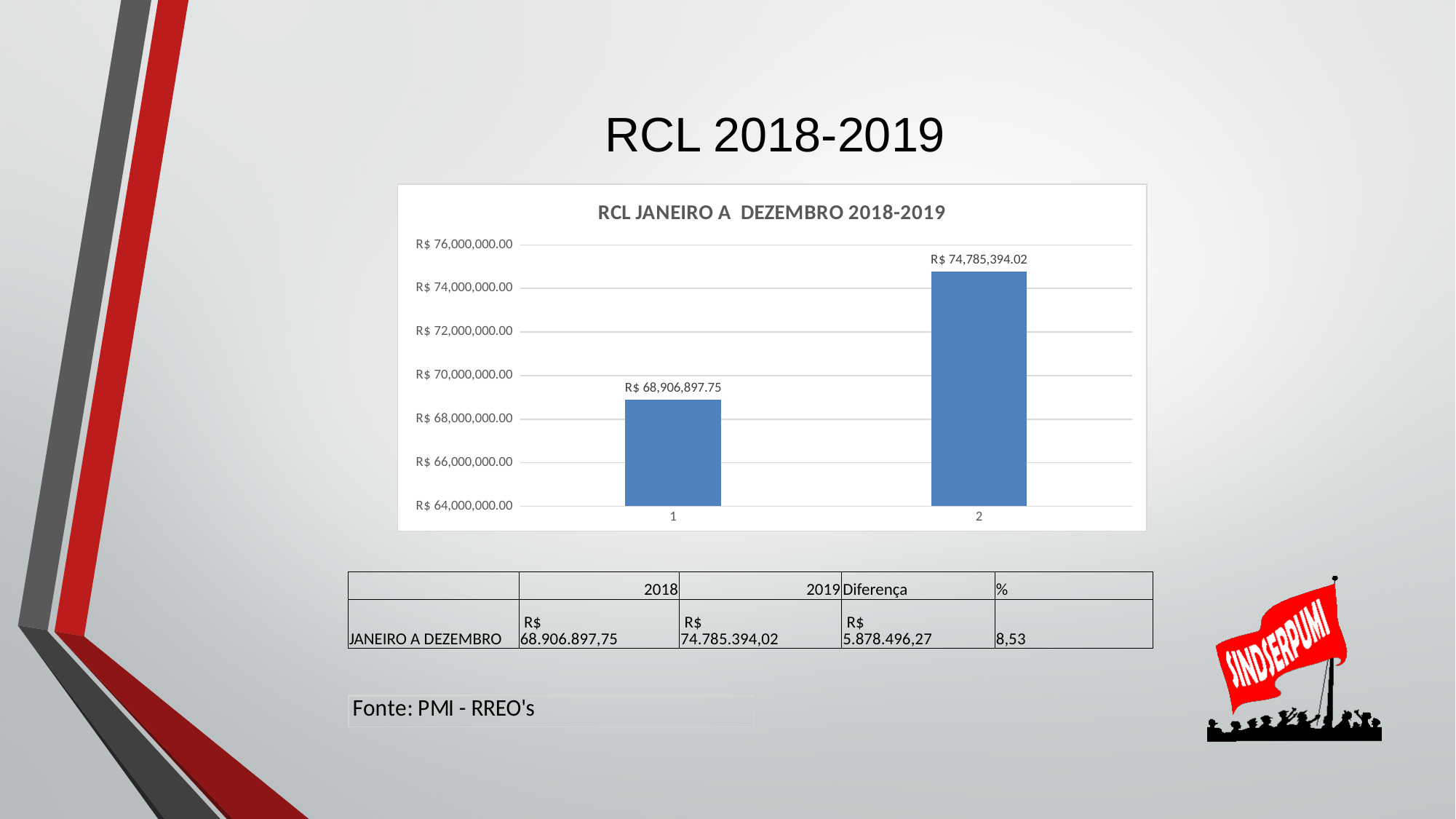
Which category has the highest value? 2 Which category has the lowest value? 1 Is the value for category 1 greater or less than R$ 70,000,000.00? less What is the difference between the value for category 2 and the value for category 1? R$ 5,878,496.27 How many bars are plotted in the chart? 2 Is the value for category 2 greater or less than R$ 74,000,000.00? greater What is the value of the bar for category 1? R$ 68,906,897.75 Which is larger, the value for category 1 or the value for category 2? category 2 What is the title of the chart? RCL JANEIRO A DEZEMBRO 2018-2019 What is the value of the bar for category 2? R$ 74,785,394.02 What kind of chart is shown on the slide? bar chart Do the values rise or fall from category 1 to category 2? rise